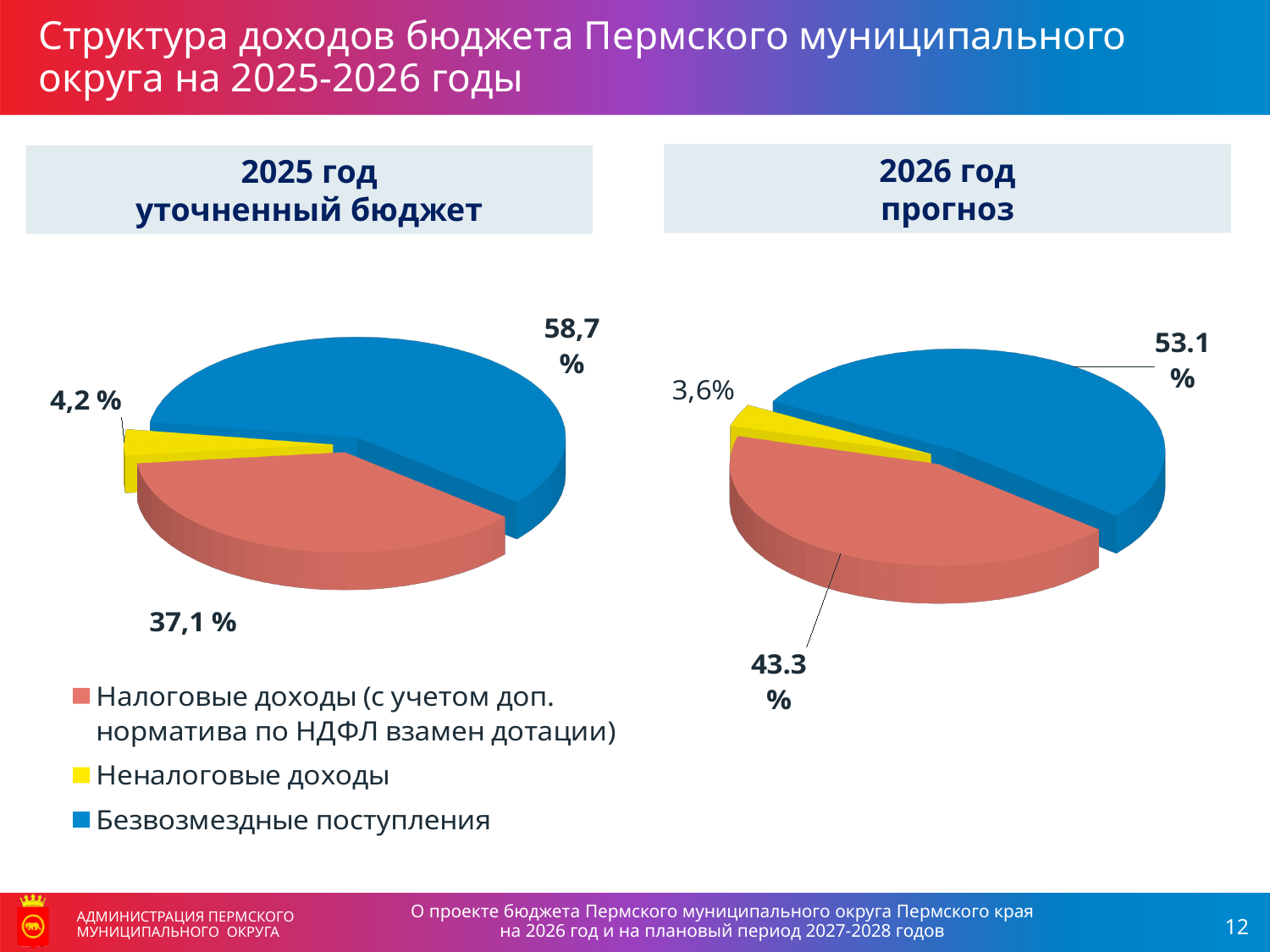
In the 2026 год прогноз pie chart, what share is shown for Неналоговые доходы? 3,6% In the 2025 год уточненный бюджет pie chart, which category has the largest slice? Безвозмездные поступления In the 2026 год прогноз pie chart, what share is shown for Налоговые доходы? 43.3 % In the 2025 год уточненный бюджет pie chart, what share is shown for Неналоговые доходы? 4,2 % In the 2026 год прогноз pie chart, what share is shown for Безвозмездные поступления? 53.1 % What type of chart is used on this slide? Pie chart In the 2026 год прогноз pie chart, which category has the smallest slice? Неналоговые доходы In the 2025 год уточненный бюджет pie chart, which is larger: Налоговые доходы or Безвозмездные поступления? Безвозмездные поступления In the 2025 год уточненный бюджет pie chart, what share is shown for Налоговые доходы? 37,1 % In the 2025 год уточненный бюджет pie chart, what share is shown for Безвозмездные поступления? 58,7 % Which colour represents Неналоговые доходы in the legend? Yellow How many categories does the legend list? 3